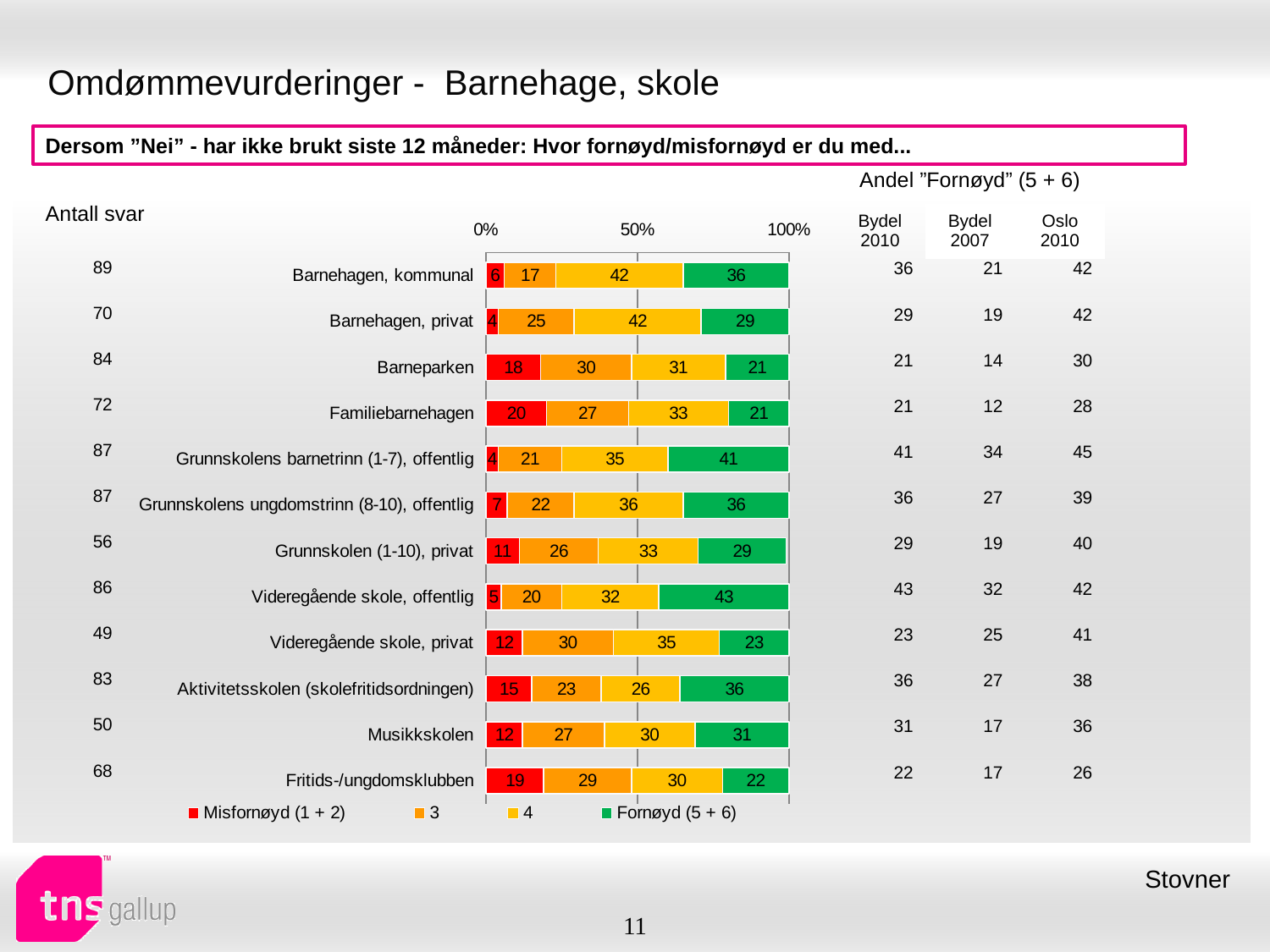
What is the total of the stacked bar for Barneparken? 100 What is the value of series 4 for Aktivitetsskolen (skolefritidsordningen)? 26 What is the Fornøyd (5 + 6) value for Barnehagen, kommunal? 36 What is the difference between the Fornøyd (5 + 6) values for Barnehagen, kommunal and Barnehagen, privat? 7 What kind of chart is shown on the slide? stacked bar chart Which category has the highest Fornøyd (5 + 6) value? Videregående skole, offentlig What is the Misfornøyd (1 + 2) value for Fritids-/ungdomsklubben? 19 How many series does the chart legend list? 4 Which has the larger Fornøyd (5 + 6) value: Videregående skole, offentlig or Videregående skole, privat? Videregående skole, offentlig What is the value of series 3 for Musikkskolen? 27 What are the four legend entries of the chart? Misfornøyd (1 + 2), 3, 4, Fornøyd (5 + 6) How many categories (services) are plotted in the chart? 12